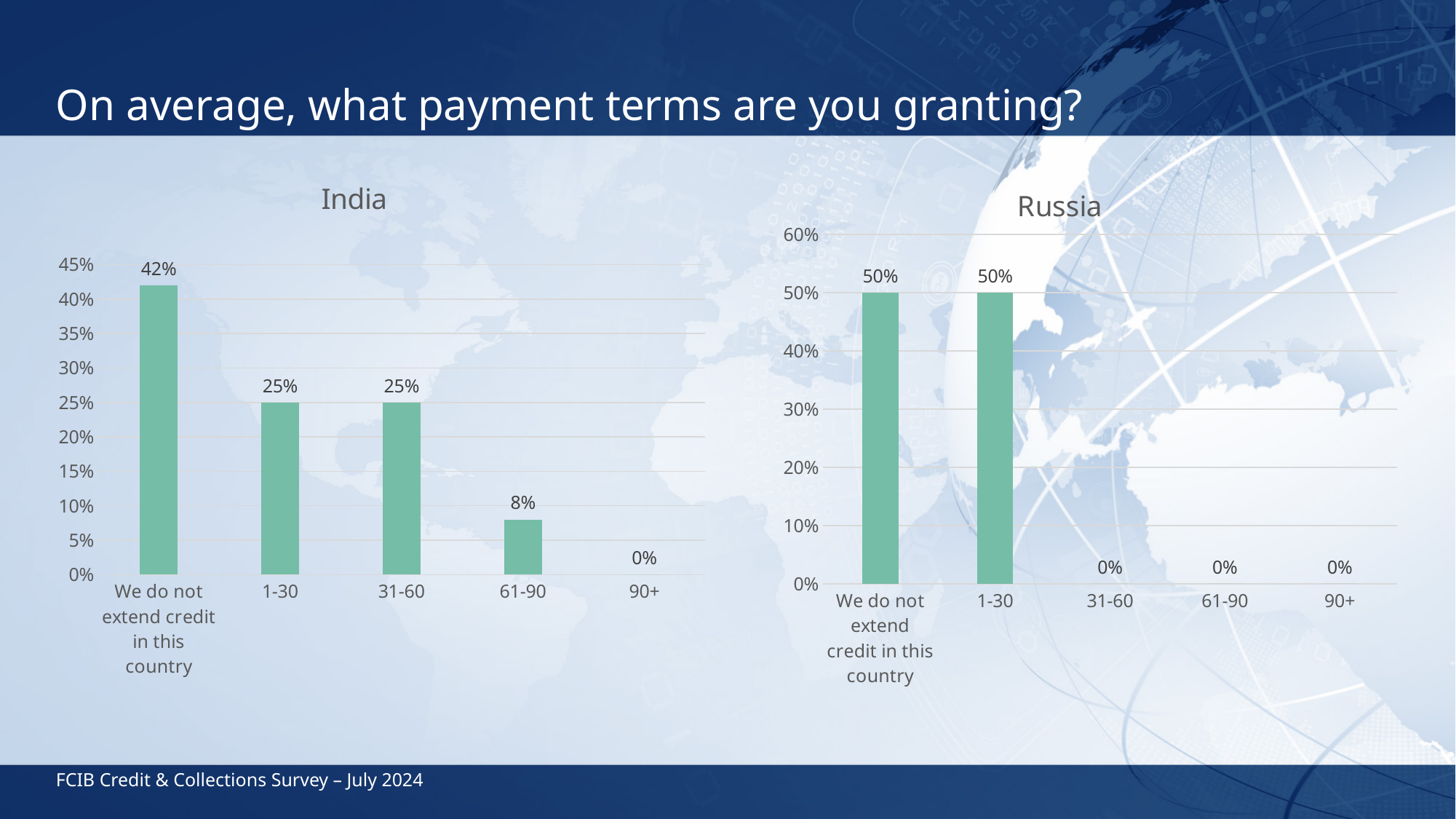
In the Russia chart, what is the value for 31-60? 0% In the India chart, what is the difference between the values for 1-30 and 61-90? 17% In the India chart, what is the value for 'We do not extend credit in this country'? 42% What kind of chart is the India chart? Bar chart In the India chart, which category has the highest value? We do not extend credit in this country In the India chart, which category has the lowest value? 90+ In the India chart, is the value for 'We do not extend credit in this country' greater or less than 40%? greater In the India chart, what is the value for 61-90? 8% In the Russia chart, is the value for 'We do not extend credit in this country' larger than the value for 31-60? Yes In the Russia chart, how many categories are shown on the x axis? 5 In the Russia chart, what is the value for 1-30? 50% What is the title of the chart on the right side of the slide? Russia